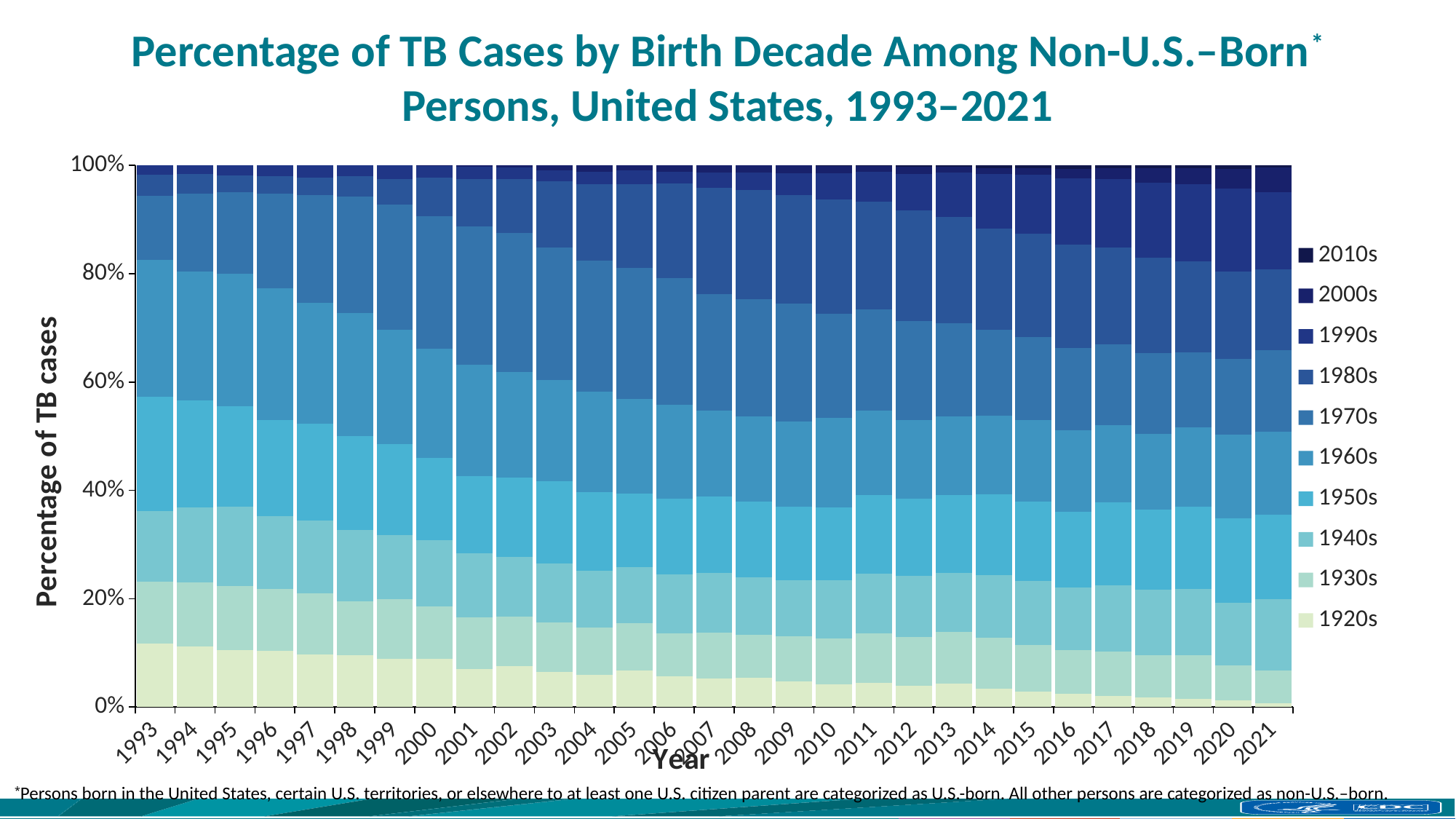
How many birth-decade series does the legend list? 10 What is the last year shown on the x axis? 2021 Which year has the larger share of TB cases among persons born in the 1920s, 1993 or 2021? 1993 Is the share of TB cases for persons born in the 1920s in 2021 greater or less than 10%? less Which year has the larger share of TB cases among persons born in the 1990s, 1993 or 2021? 2021 What kind of chart is shown on the slide? Stacked bar chart Is the share of TB cases for persons born in the 1960s in 1993 greater or less than 20%? greater How many years (bars) are plotted along the x axis? 29 What does each stacked bar total on the y axis? 100% Does the share of TB cases among persons born in the 2000s rise or fall from 1993 to 2021? Rise Does the share of TB cases among persons born in the 1920s rise or fall from 1993 to 2021? Fall What is the first year shown on the x axis? 1993